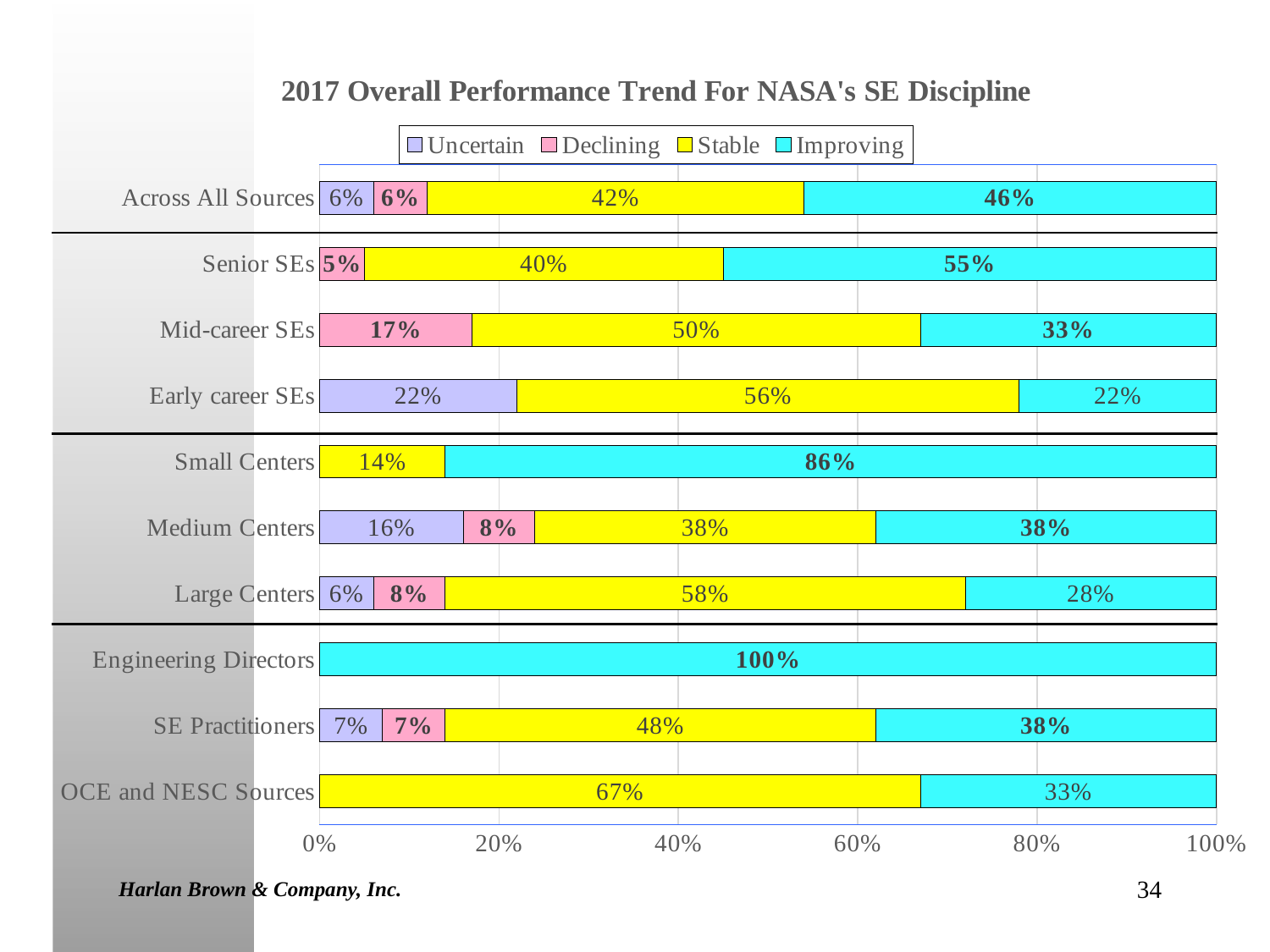
What kind of chart is shown on the slide? Stacked bar chart How many series does the legend list? 4 Which category has the lowest Stable value among those with a Stable segment? Small Centers What is the title of the chart? 2017 Overall Performance Trend For NASA's SE Discipline Which is larger, the Stable value for OCE and NESC Sources or the Stable value for SE Practitioners? OCE and NESC Sources What is the Improving value for Senior SEs? 55% Which category has the highest Improving value? Engineering Directors What is the Stable value for Early career SEs? 56% What is the Uncertain value for Medium Centers? 16% What is the difference between the Improving values for Small Centers and Large Centers? 58% What is the Declining value for Mid-career SEs? 17% How many categories are plotted on the chart? 10